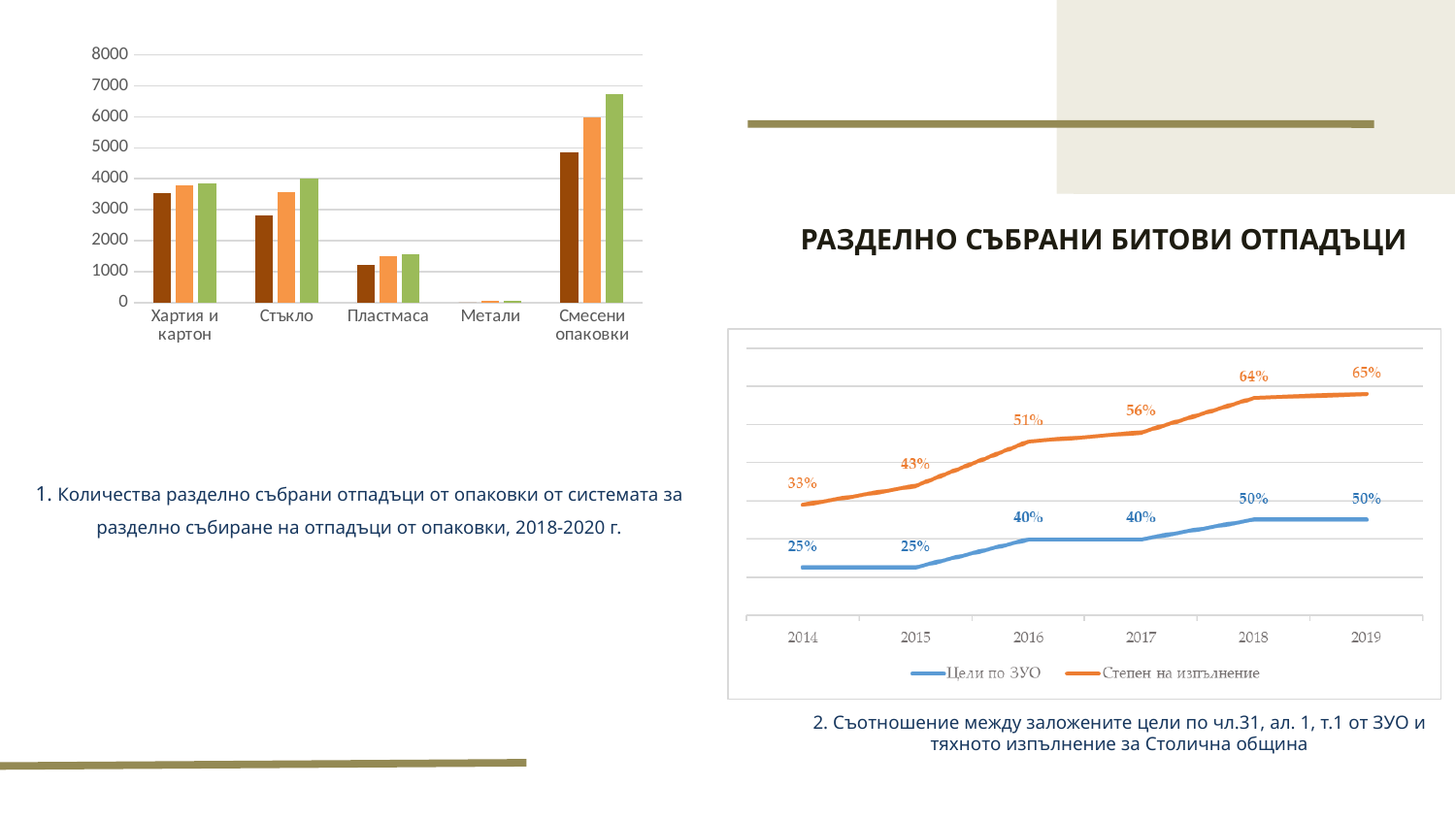
In the bar chart on the left, is the value of the green bar for Смесени опаковки greater or less than 6000? greater How many categories are shown on the x axis of the bar chart on the left? 5 In the line chart on the right, does Степен на изпълнение rise or fall from 2014 to 2019? rise What kind of chart is the chart on the left of the slide? bar chart In the line chart on the right, what is the difference between Степен на изпълнение and Цели по ЗУО in 2019? 15 percentage points In the bar chart on the left, which category has the lowest bars? Метали In the line chart on the right, which series has the higher value in 2014, Цели по ЗУО or Степен на изпълнение? Степен на изпълнение In the bar chart on the left, is the value of the brown bar for Пластмаса greater or less than 2000? less In the bar chart on the left, which category has the tallest bars? Смесени опаковки In the line chart on the right, what is the value of Степен на изпълнение in 2017? 56% How many series does the legend of the line chart on the right list? 2 In the line chart on the right, what is the value of Цели по ЗУО in 2016? 40%